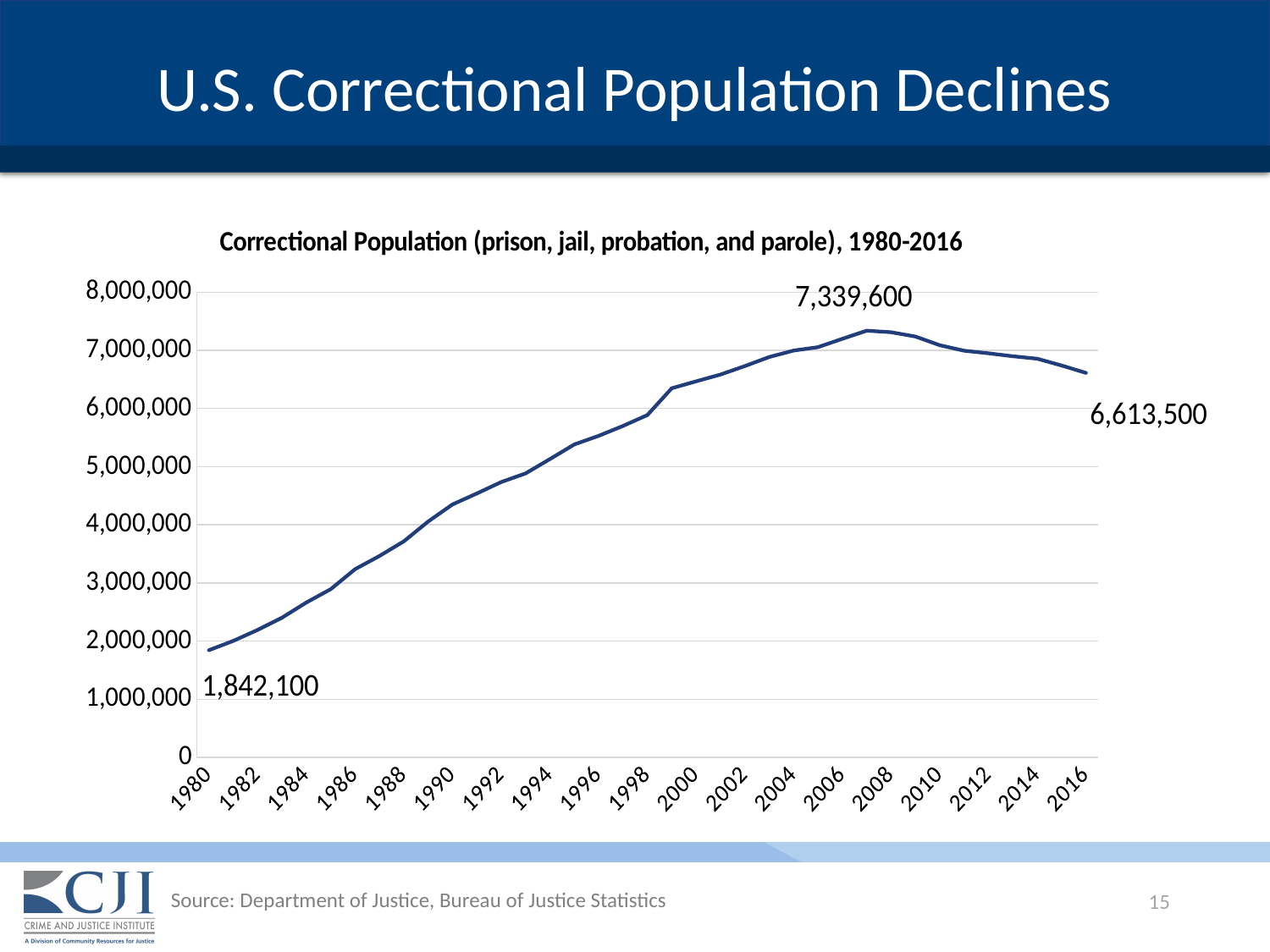
By how much did the correctional population increase from 1980 to 2016? 4,771,400 What was the correctional population in 2016? 6,613,500 What is the highest value labeled on the line? 7,339,600 Is the value for 1984 greater or less than 3,000,000? less How much lower is the 2016 value than the peak value of 7,339,600? 726,100 What kind of chart is shown on the slide? line chart In which year was the correctional population lowest? 1980 Does the correctional population rise or fall between 1980 and 2000? rise What was the correctional population in 1980? 1,842,100 What is the title of the chart? Correctional Population (prison, jail, probation, and parole), 1980-2016 Which year had the larger correctional population, 1980 or 2016? 2016 Is the value for 1990 greater or less than 4,000,000? greater